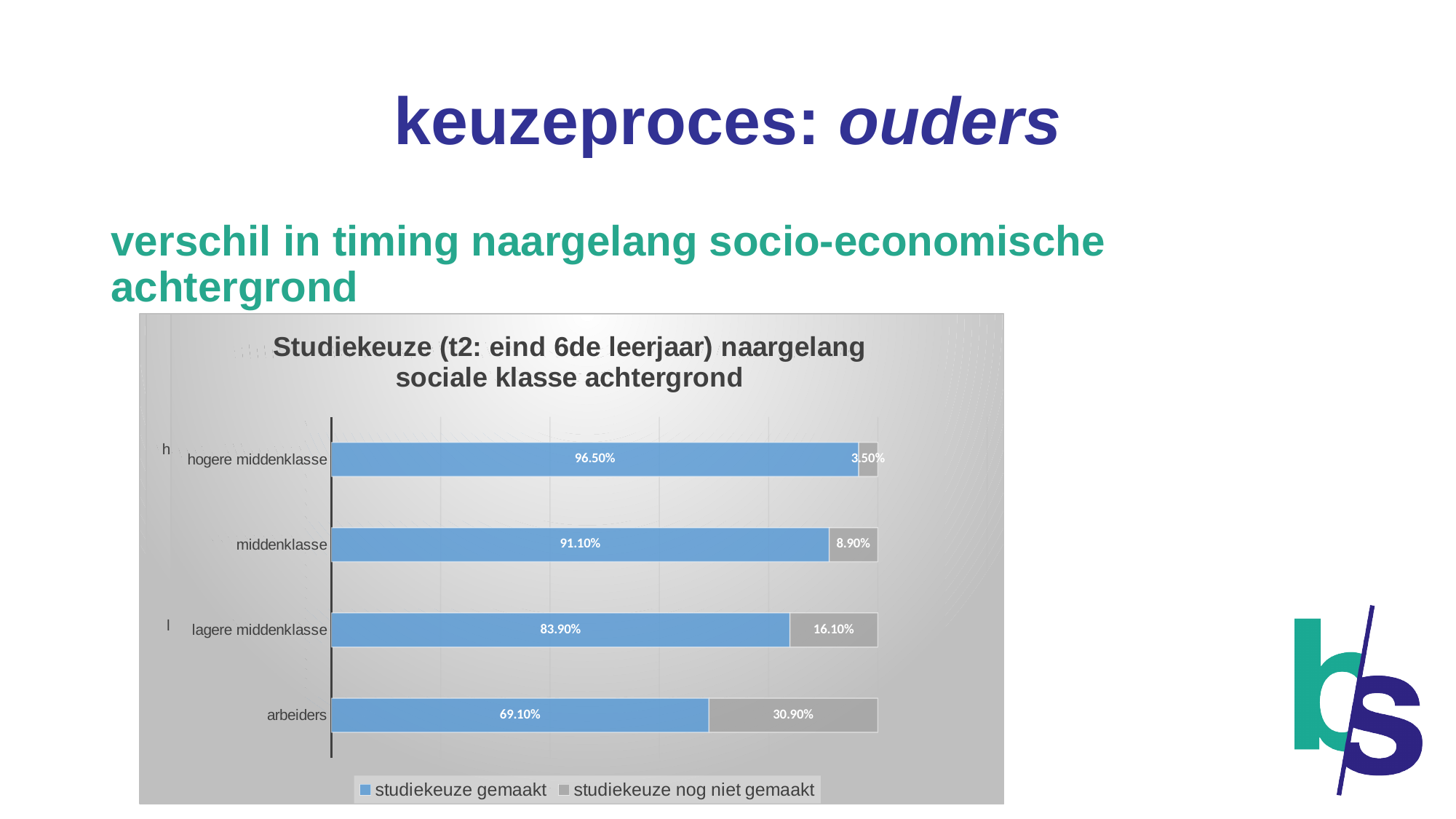
Which is larger: the 'studiekeuze nog niet gemaakt' value for 'lagere middenklasse' or for 'middenklasse'? lagere middenklasse Which category has the lowest share of 'studiekeuze gemaakt'? arbeiders How many series does the legend list? 2 What percentage of the 'arbeiders' group has not yet made a study choice (studiekeuze nog niet gemaakt)? 30.90% How many categories are shown on the chart? 4 What is the title of the chart? Studiekeuze (t2: eind 6de leerjaar) naargelang sociale klasse achtergrond What is the value for 'studiekeuze gemaakt' in the 'lagere middenklasse' category? 83.90% What kind of chart is shown on the slide? stacked bar chart What percentage of the 'hogere middenklasse' group has made a study choice (studiekeuze gemaakt)? 96.50% What is the value for 'studiekeuze nog niet gemaakt' in the 'middenklasse' category? 8.90% Which category has the highest share of 'studiekeuze gemaakt'? hogere middenklasse What is the difference between the 'studiekeuze gemaakt' values for 'hogere middenklasse' and 'arbeiders'? 27.40%